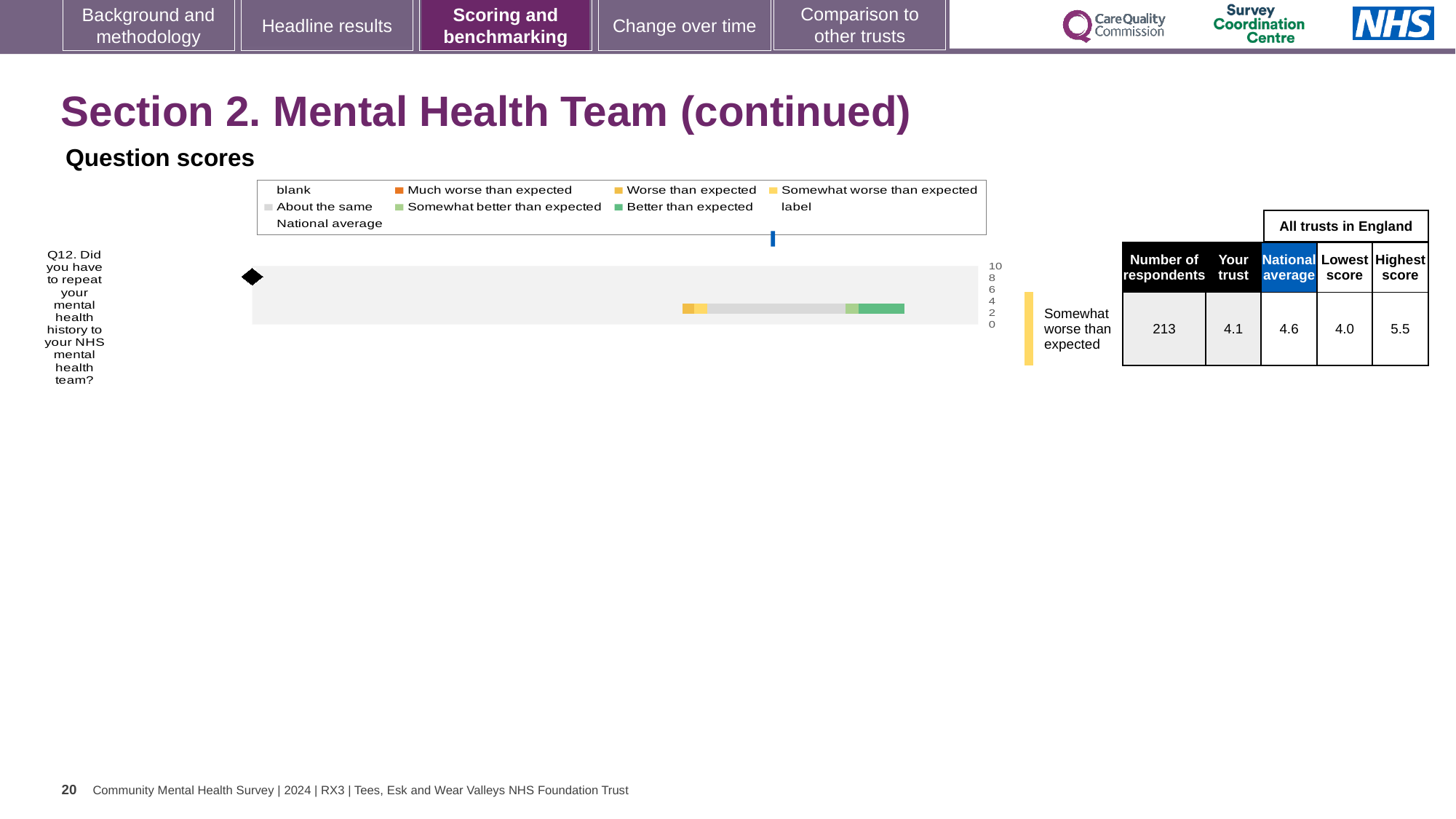
Which benchmarking category is the trust's Q12 score placed in? Somewhat worse than expected What is the number of respondents shown for Q12? 213 What is the lowest score among all trusts in England for Q12? 4.0 What is the 'Your trust' score for Q12? 4.1 Which question is shown on the chart? Q12. Did you have to repeat your mental health history to your NHS mental health team? Which is larger for Q12, the 'Your trust' score or the national average? National average What is the highest score among all trusts in England for Q12? 5.5 What is the difference between the national average and the 'Your trust' score for Q12? 0.5 What kind of chart is used to show the Q12 benchmarking? Stacked bar chart How many questions are plotted on the chart? 1 What is the national average score for Q12? 4.6 What is the difference between the highest and lowest scores for Q12 across all trusts in England? 1.5